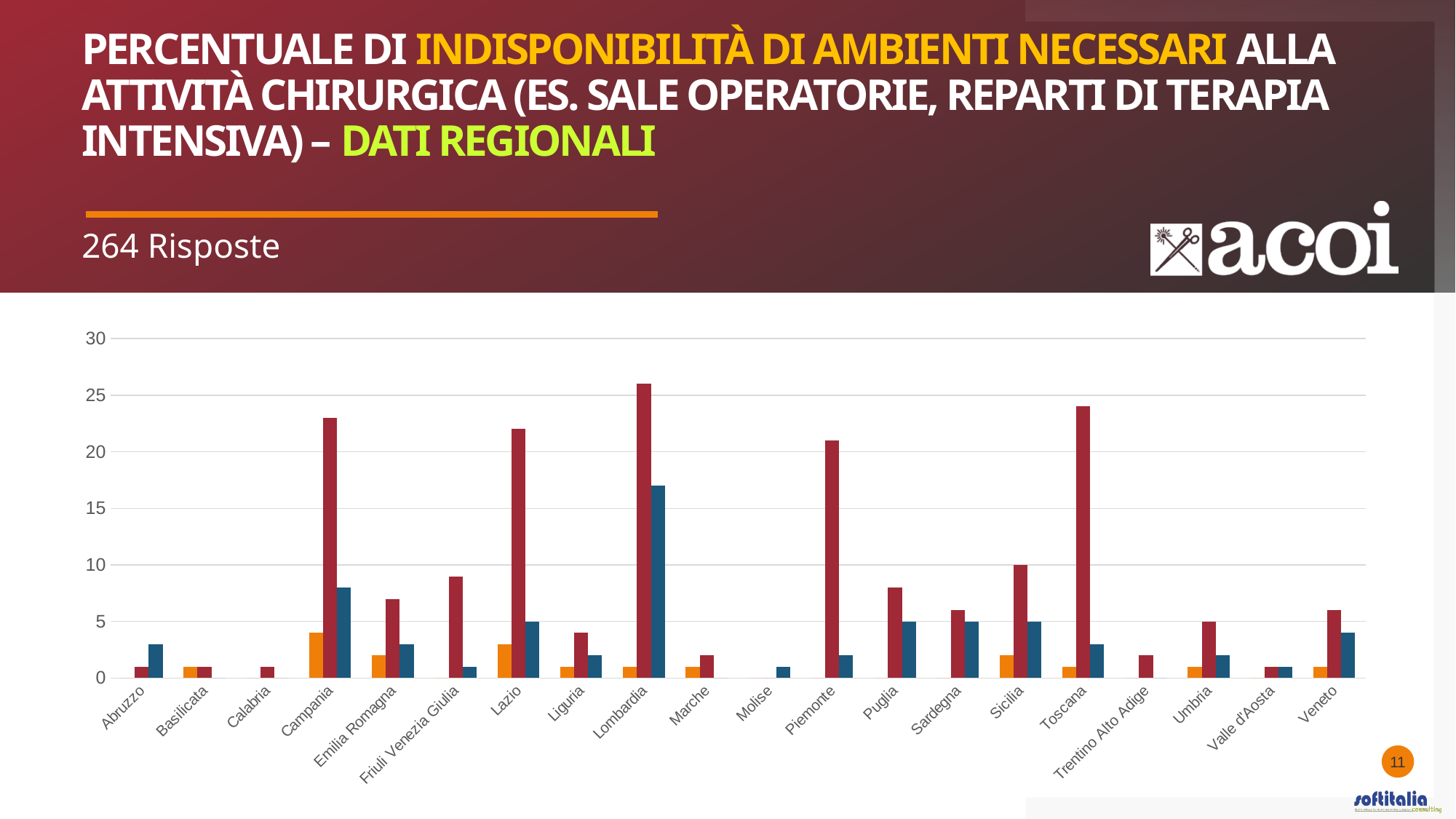
Which region has the tallest blue bar in the chart? Lombardia What kind of chart is shown on the slide? bar chart Which is larger, the red bar for Piemonte or the red bar for Puglia? Piemonte Is the red bar for Toscana greater or less than 20? greater How many responses does the slide say the chart is based on? 264 Risposte How many regions are listed along the x axis of the chart? 20 Which is larger, the blue bar for Lombardia or the blue bar for Campania? Lombardia Is the red bar for Lombardia greater or less than 25? greater Is the red bar for Emilia Romagna greater or less than 10? less Which region has the tallest red bar in the chart? Lombardia Which region has the tallest orange bar in the chart? Campania